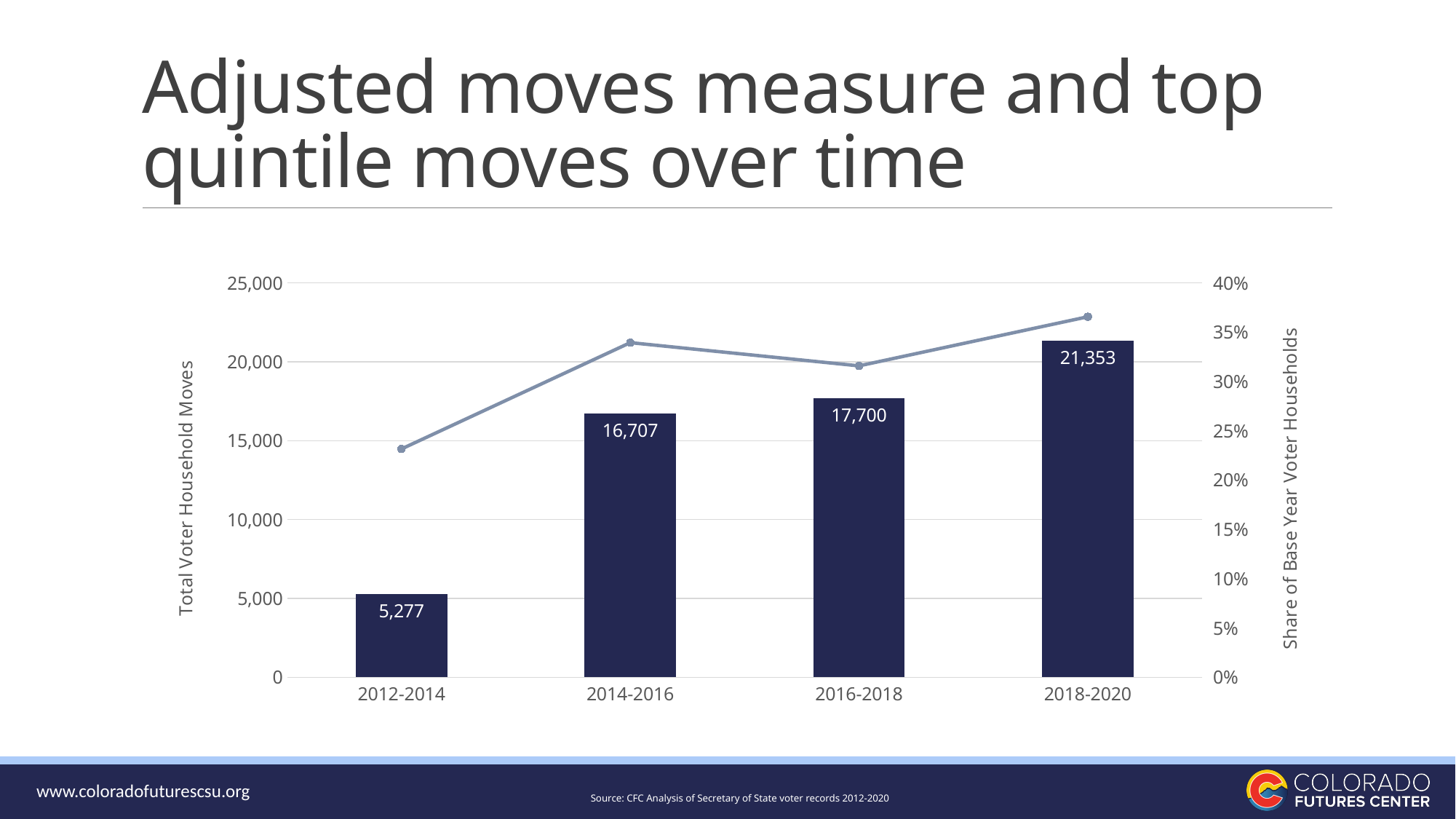
Which period has more total voter household moves, 2014-2016 or 2016-2018? 2016-2018 Which period has the lowest total voter household moves? 2012-2014 What is the total voter household moves value for 2016-2018? 17,700 What is the total voter household moves value for 2018-2020? 21,353 What is the total voter household moves value for 2012-2014? 5,277 Is the share of base year voter households for 2012-2014 greater or less than 25%? less How many time periods are shown on the x axis? 4 Is the share of base year voter households for 2018-2020 greater or less than 35%? greater What is the difference in total voter household moves between 2018-2020 and 2012-2014? 16,076 Which period has the highest total voter household moves? 2018-2020 What is the difference in total voter household moves between 2016-2018 and 2014-2016? 993 Do the total voter household moves rise or fall from 2012-2014 to 2018-2020? rise